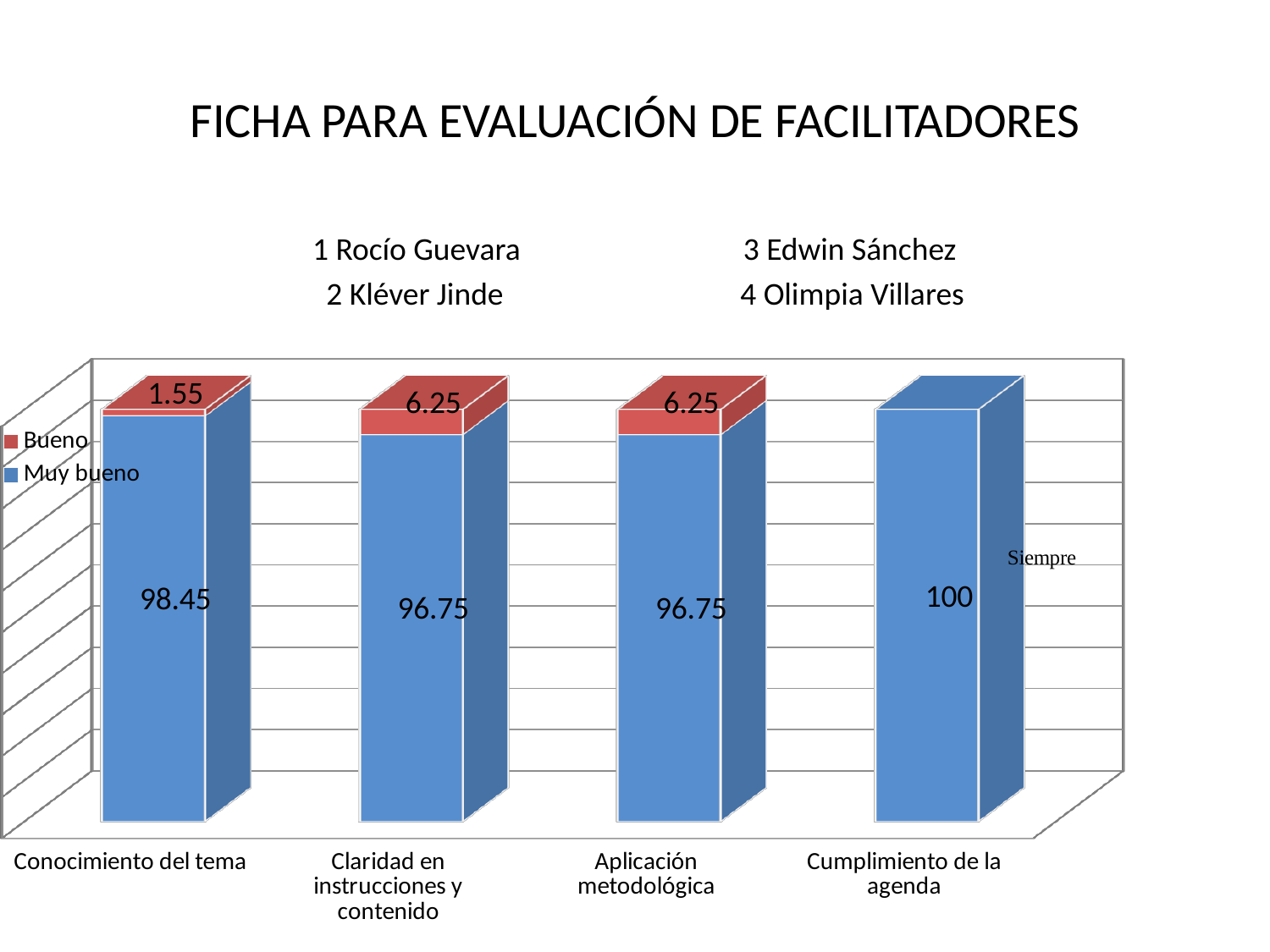
What is the difference between the Muy bueno values for Conocimiento del tema and Claridad en instrucciones y contenido? 1.7 How many categories are shown on the x axis? 4 Which category has the highest Muy bueno value? Cumplimiento de la agenda What is the Bueno value for Aplicación metodológica? 6.25 What is the value shown for Cumplimiento de la agenda? 100 What is the Bueno value for Conocimiento del tema? 1.55 Which is larger, the Bueno value for Conocimiento del tema or the Bueno value for Claridad en instrucciones y contenido? Claridad en instrucciones y contenido What is the Muy bueno value for Conocimiento del tema? 98.45 What is the Muy bueno value for Claridad en instrucciones y contenido? 96.75 How many series does the legend list? 2 Which category has the lowest Bueno value among those with a Bueno segment? Conocimiento del tema What kind of chart is shown on the slide? Stacked bar chart